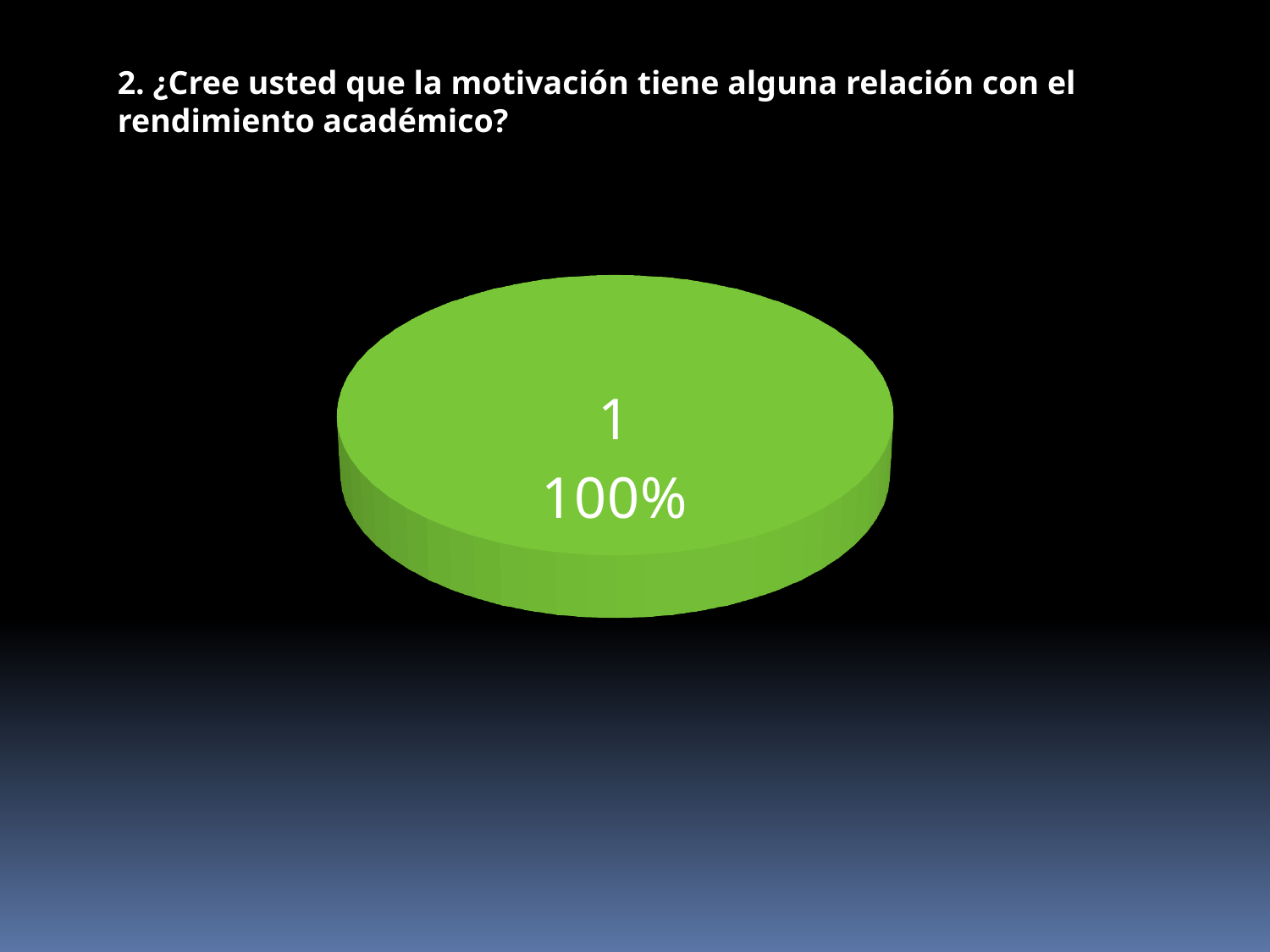
How many slices does the pie chart have? 1 What kind of chart is shown on the slide? pie chart What value label is printed on the pie slice above the percentage? 1 What percentage share is printed on the single slice of the pie chart? 100% What colour is the pie chart's slice? green Does the pie chart show a legend? No